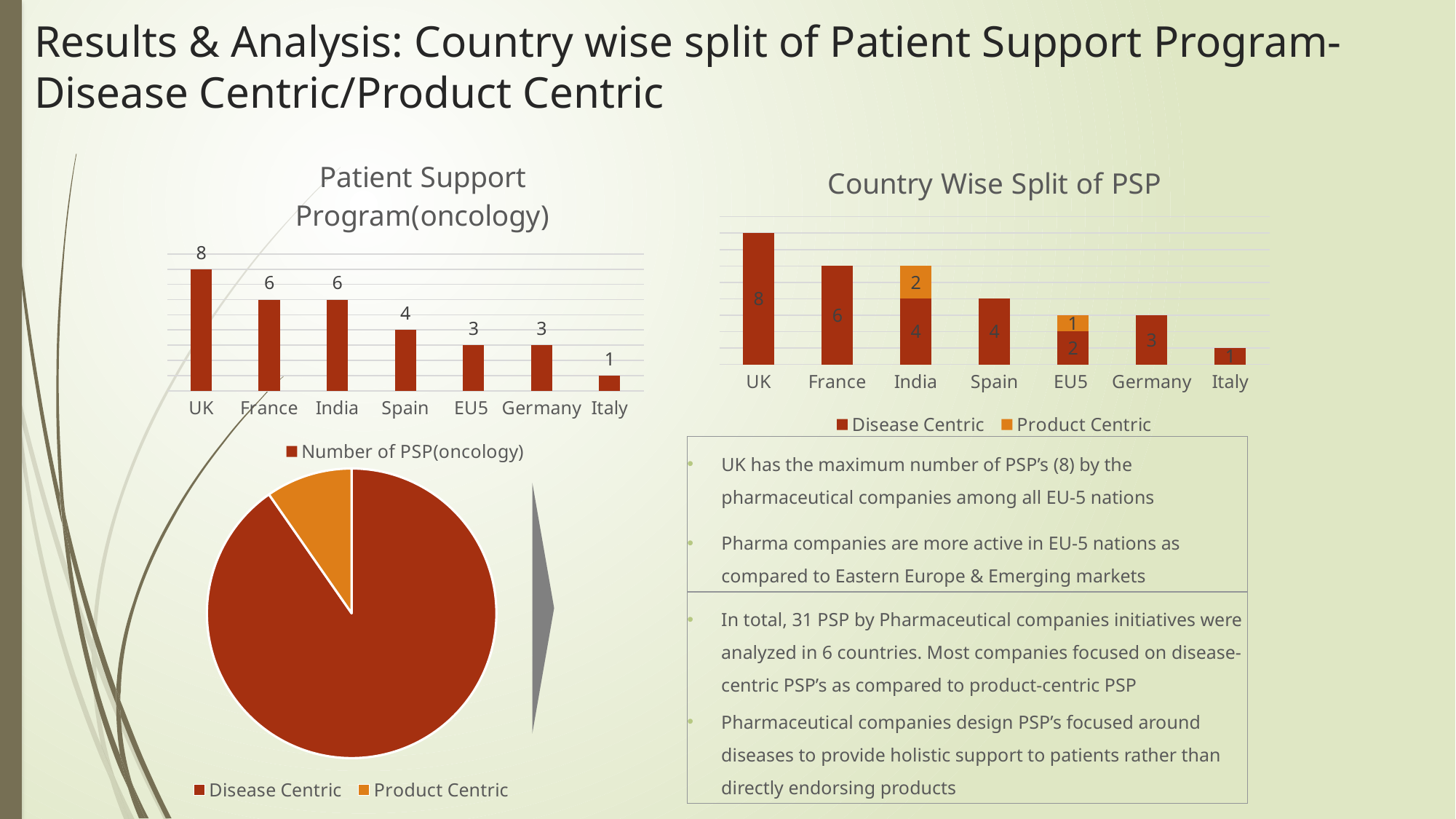
What kind of chart is the 'Country Wise Split of PSP' chart? stacked bar chart In the 'Country Wise Split of PSP' chart, what is the total of the stacked bar for India? 6 In the 'Patient Support Program(oncology)' chart, do the values generally rise or fall from left to right? fall In the 'Country Wise Split of PSP' chart, what is the total of the stacked bar for EU5? 3 In the 'Patient Support Program(oncology)' chart, which country has the lowest number of PSP? Italy In the 'Patient Support Program(oncology)' chart, what is the difference between the values for UK and Spain? 4 In the 'Country Wise Split of PSP' chart, what is the Product Centric value for India? 2 In the 'Patient Support Program(oncology)' chart, which is larger, the value for France or the value for EU5? France In the pie chart at the bottom left, which slice is larger, Disease Centric or Product Centric? Disease Centric In the 'Patient Support Program(oncology)' chart, what is the value for UK? 8 In the 'Patient Support Program(oncology)' chart, how many countries are shown on the x axis? 7 In the 'Country Wise Split of PSP' chart, how many series does the legend list? 2